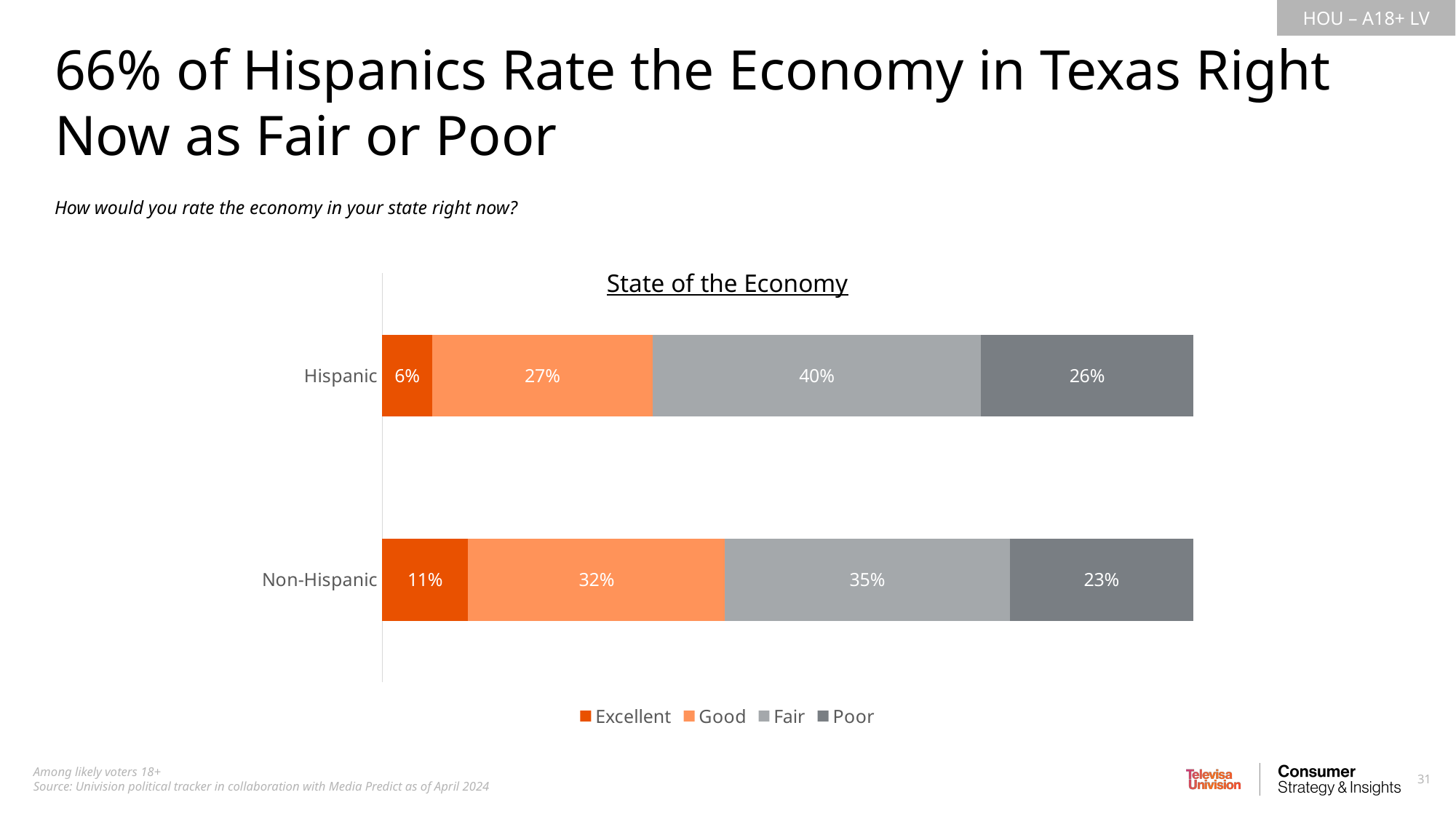
Which rating category has the smallest share among Non-Hispanic respondents? Excellent What percentage of Hispanic respondents rate the economy as Fair? 40% What percentage of Non-Hispanic respondents rate the economy as Good? 32% Which rating category has the largest share among Hispanic respondents? Fair How many series does the legend list? 4 What is the combined Fair and Poor share for Hispanic respondents? 66% What is the difference between the Good share for Non-Hispanic and Hispanic respondents? 5 percentage points What percentage of Hispanic respondents rate the economy as Poor? 26% What percentage of Non-Hispanic respondents rate the economy as Excellent? 11% Which group has a larger Poor share, Hispanic or Non-Hispanic? Hispanic What kind of chart is shown on the slide? Stacked bar chart What is the title of the chart? State of the Economy